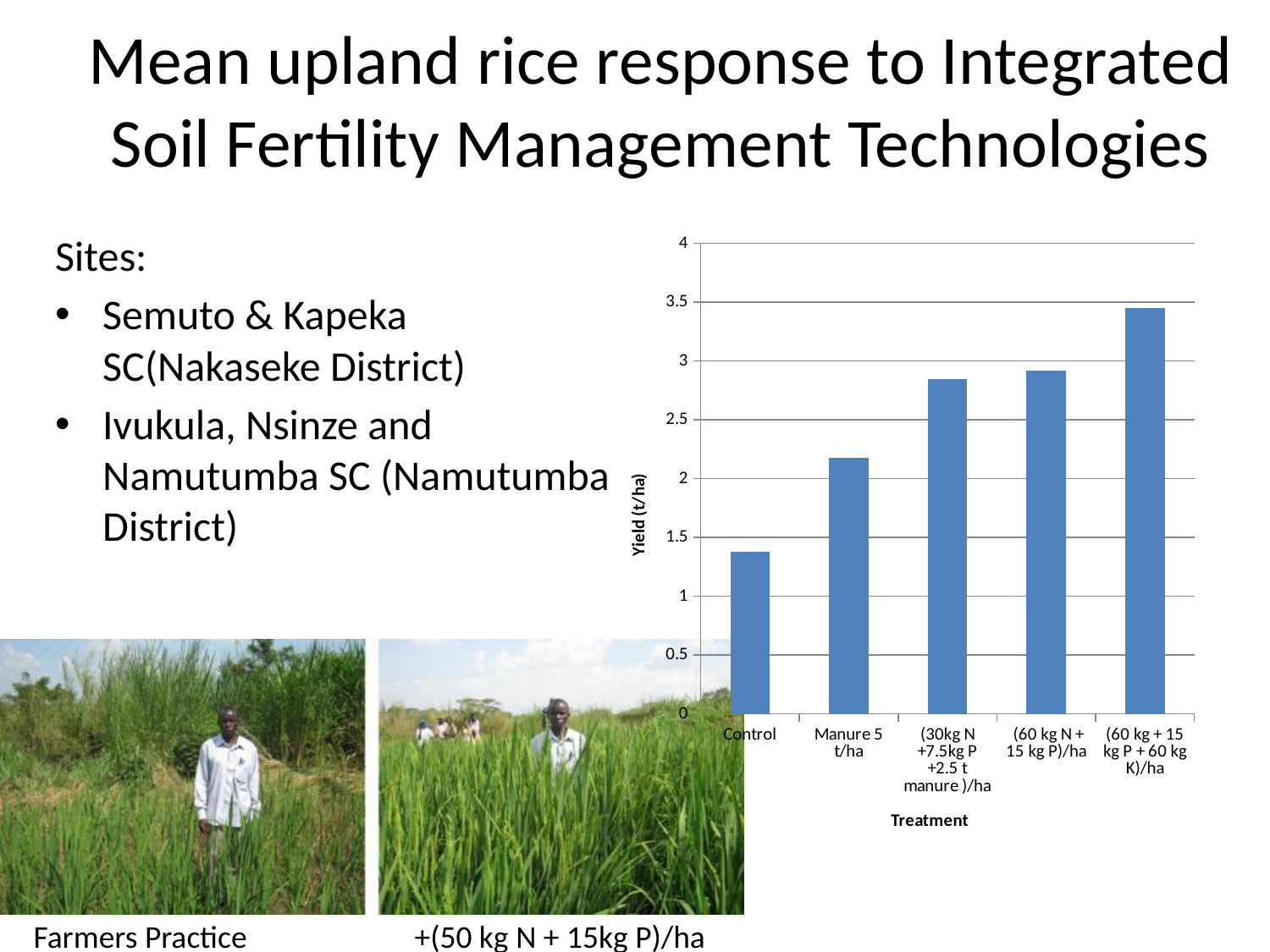
Is the yield for (60 kg + 15 kg P + 60 kg K)/ha greater or less than 3? greater Which has the larger yield, Control or Manure 5 t/ha? Manure 5 t/ha What is the label on the vertical axis of the chart? Yield (t/ha) Which has the larger yield, Manure 5 t/ha or (60 kg + 15 kg P + 60 kg K)/ha? (60 kg + 15 kg P + 60 kg K)/ha Do the yields rise or fall moving from Control to the rightmost treatment on the x axis? rise Which treatment has the lowest yield on the chart? Control Is the yield for Manure 5 t/ha greater or less than 2? greater How many treatment categories are plotted on the chart? 5 Is the yield for (30kg N +7.5kg P +2.5 t manure )/ha greater or less than 2.5? greater What kind of chart is shown on the slide? bar chart Which treatment has the highest yield on the chart? (60 kg + 15 kg P + 60 kg K)/ha